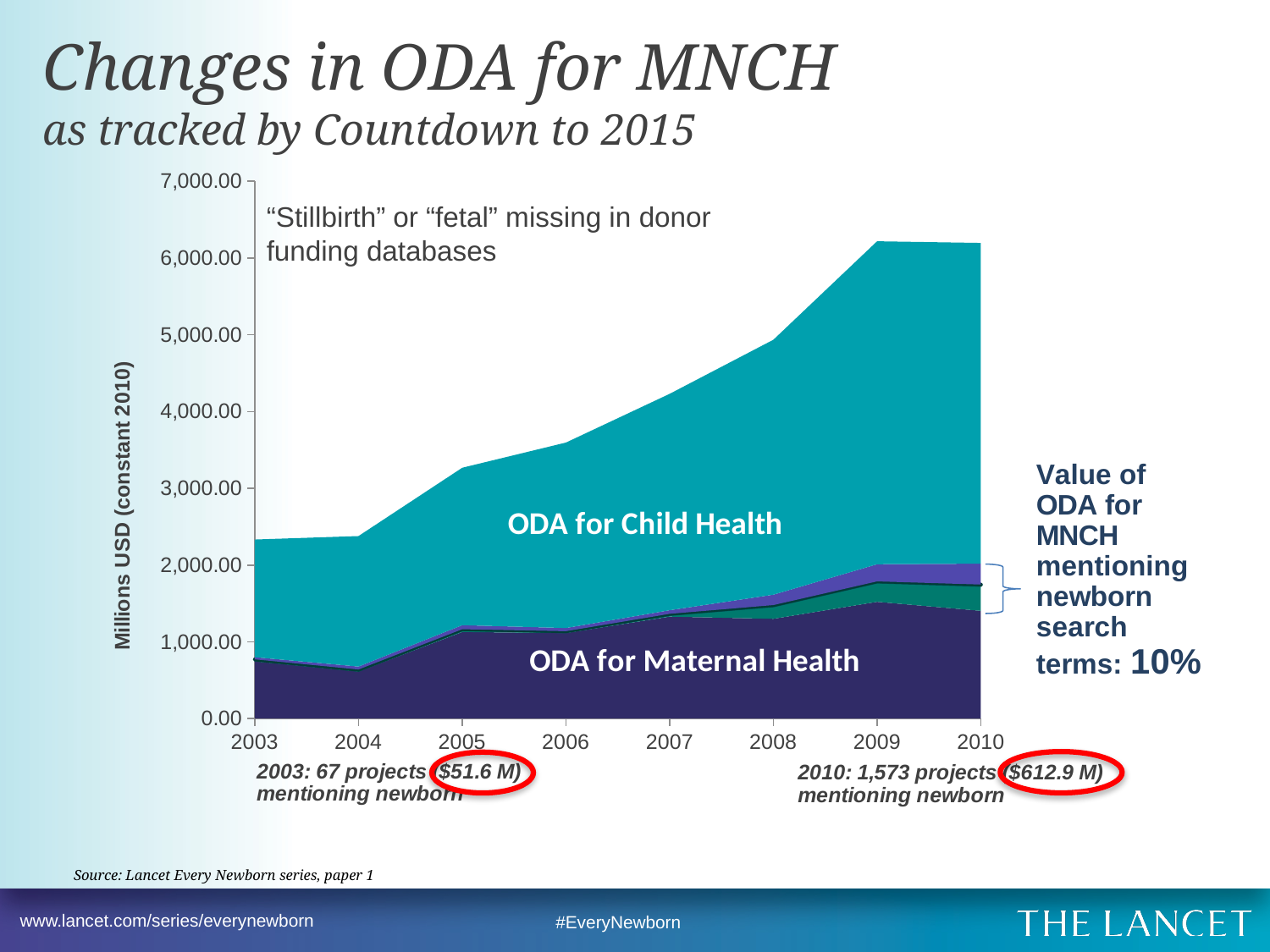
What was the value of projects mentioning newborn in 2010? $612.9 M Does total ODA for MNCH rise or fall from 2003 to 2010? Rise How many projects mentioning newborn were there in 2003? 67 What is the label of the y axis? Millions USD (constant 2010) Is the total ODA value in 2006 greater or less than 3,000.00? greater Is the ODA for Maternal Health value in 2004 greater or less than 1,000.00? less How many years are shown along the x axis of the chart? 8 What kind of chart is shown on the slide? Stacked area chart By how much did the value of projects mentioning newborn increase from 2003 ($51.6 M) to 2010 ($612.9 M)? $561.3 M Is the total ODA value in 2003 greater or less than 3,000.00? less Which is larger, ODA for Child Health or ODA for Maternal Health in 2010? ODA for Child Health What share of the value of ODA for MNCH mentions newborn search terms? 10%